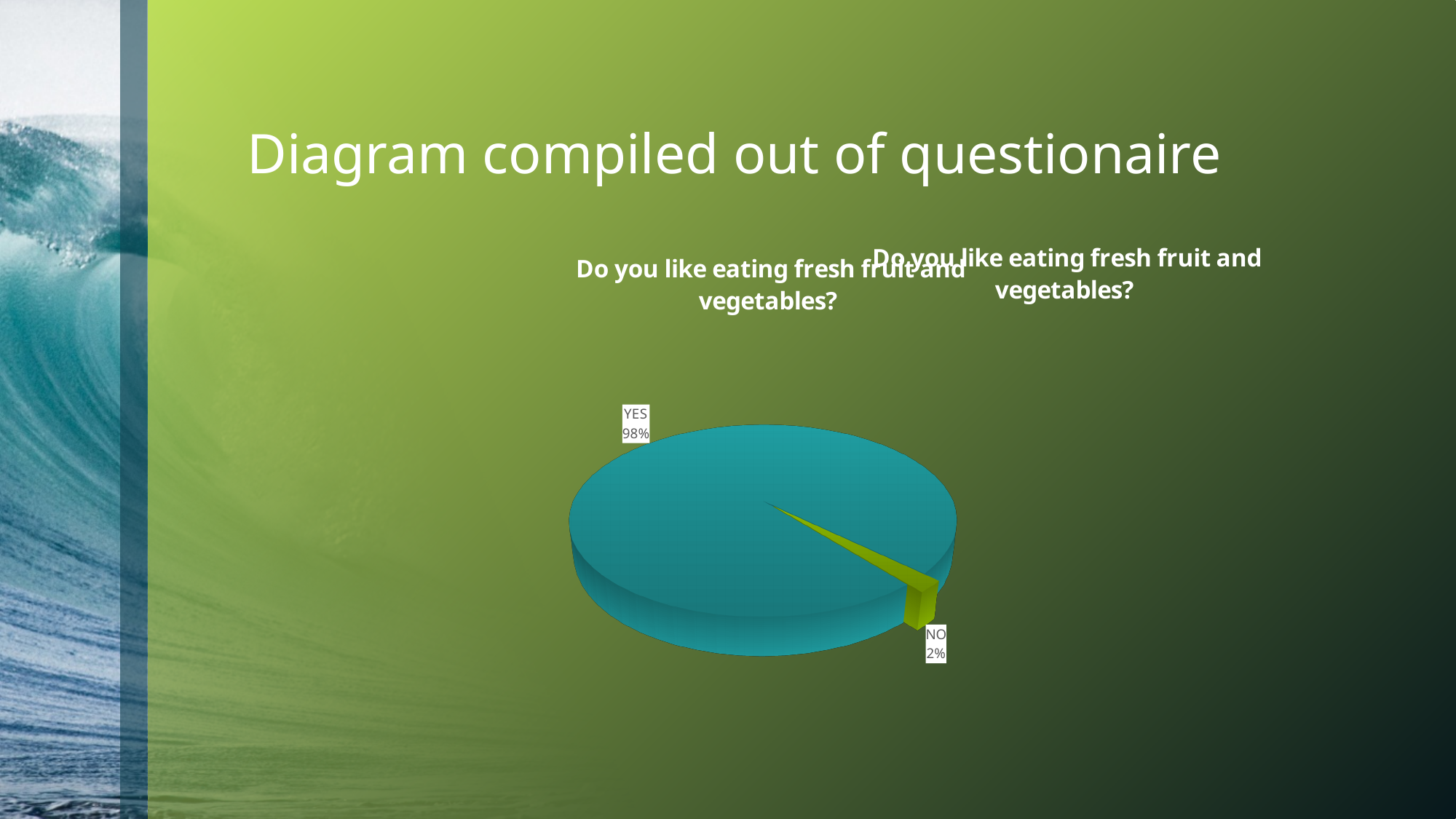
What is the difference in percentage points between the YES and NO slices? 96 Which answer has the largest share of the pie? YES What percentage of respondents answered YES? 98% What kind of chart is shown on the slide? pie chart What question does the chart title ask? Do you like eating fresh fruit and vegetables? What colour is the YES slice of the pie? teal Which slice is larger, YES or NO? YES How many slices does the pie chart have? 2 What percentage of respondents answered NO? 2% Which answer has the smallest share of the pie? NO